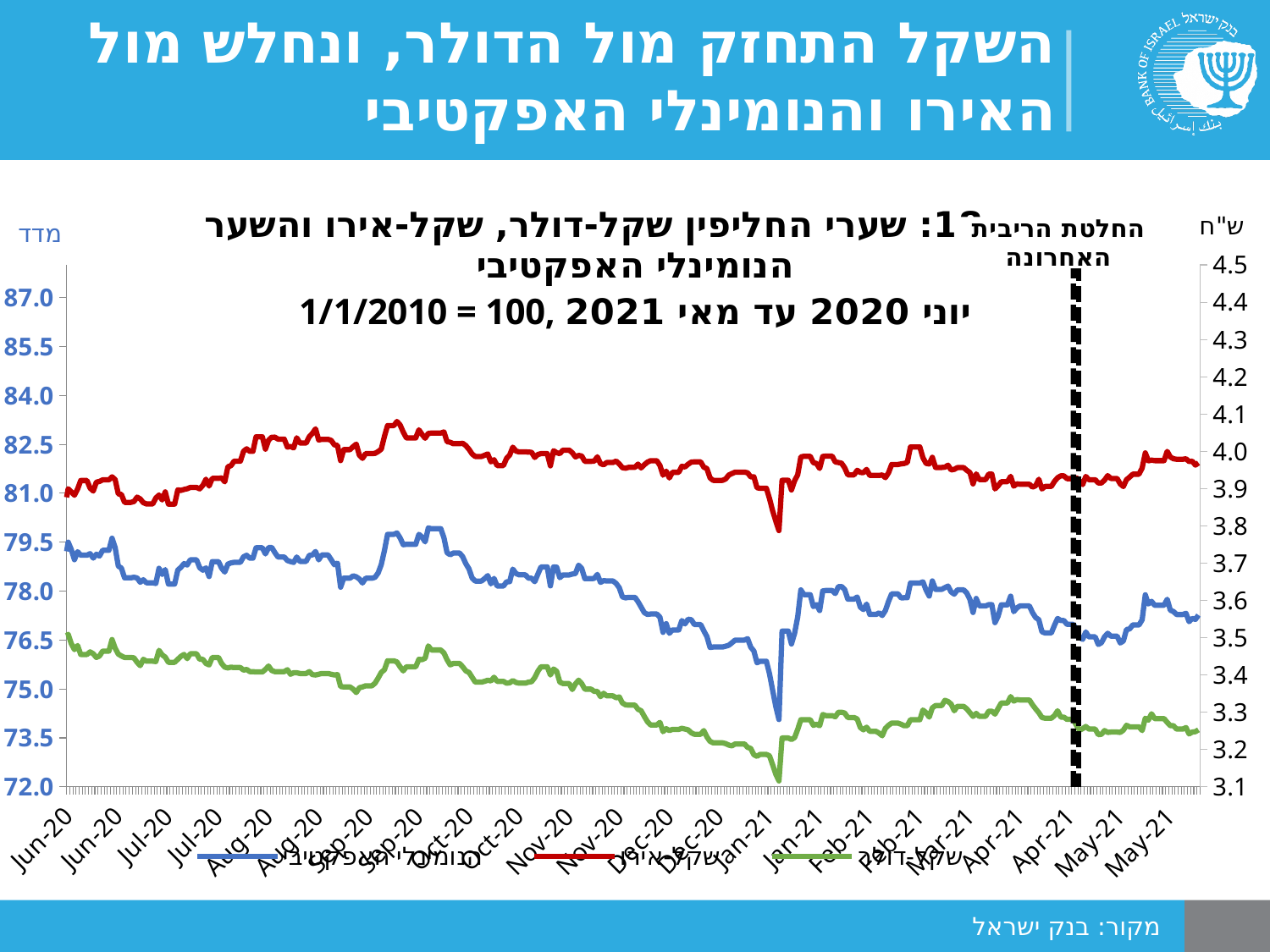
Is the value of the שער נומינלי אפקטיבי series in May-21 greater or less than 78.0? less Is the value of the שקל-דולר series in Jun-20 greater or less than 3.4? greater Is the value of the שקל-אירו series in May-21 greater or less than 3.9? greater Does the שקל-דולר series rise or fall overall from Jun-20 to May-21? fall What does the dashed vertical line on the chart mark? החלטת הריבית האחרונה Which series is plotted in red? שקל-אירו Which is higher in May-21, the שקל-אירו series or the שקל-דולר series? שקל-אירו What kind of chart is shown on the slide? line chart In which month does the שקל-דולר series reach its lowest point? Jan-21 How many series does the chart's legend list? 3